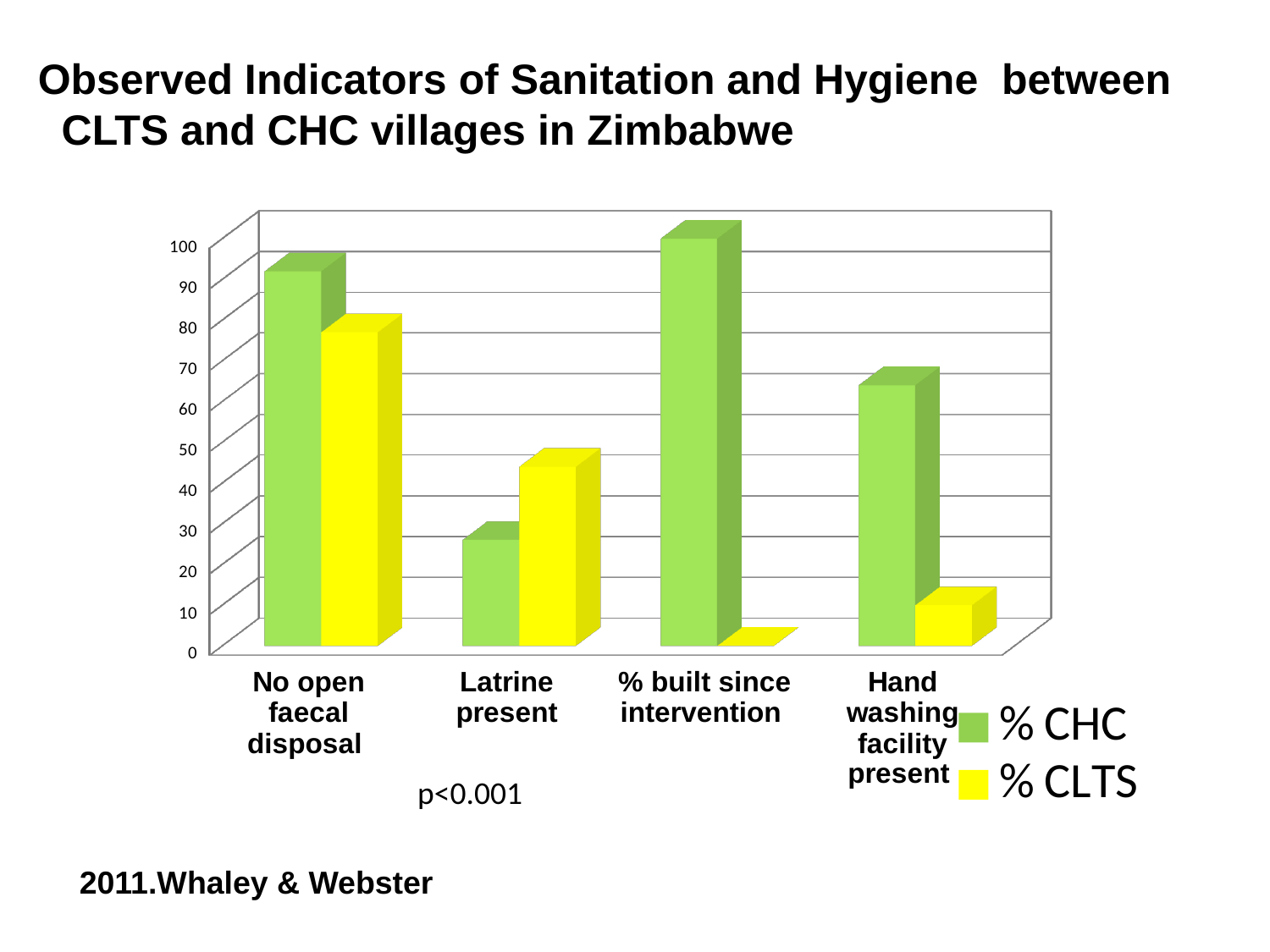
How many categories are shown on the x axis? 4 For Latrine present, which series has the larger value, % CHC or % CLTS? % CLTS How many series does the legend list? 2 For Hand washing facility present, which series has the larger value, % CHC or % CLTS? % CHC Which category has the highest % CHC value? % built since intervention Which category has the lowest % CLTS value? % built since intervention Is the % CLTS value for Latrine present greater or less than 60? less Which category has the lowest % CHC value? Latrine present What kind of chart is shown on the slide? bar chart Which category has the highest % CLTS value? No open faecal disposal Is the % CHC value for Hand washing facility present greater or less than 50? greater What colour are the % CLTS bars? yellow